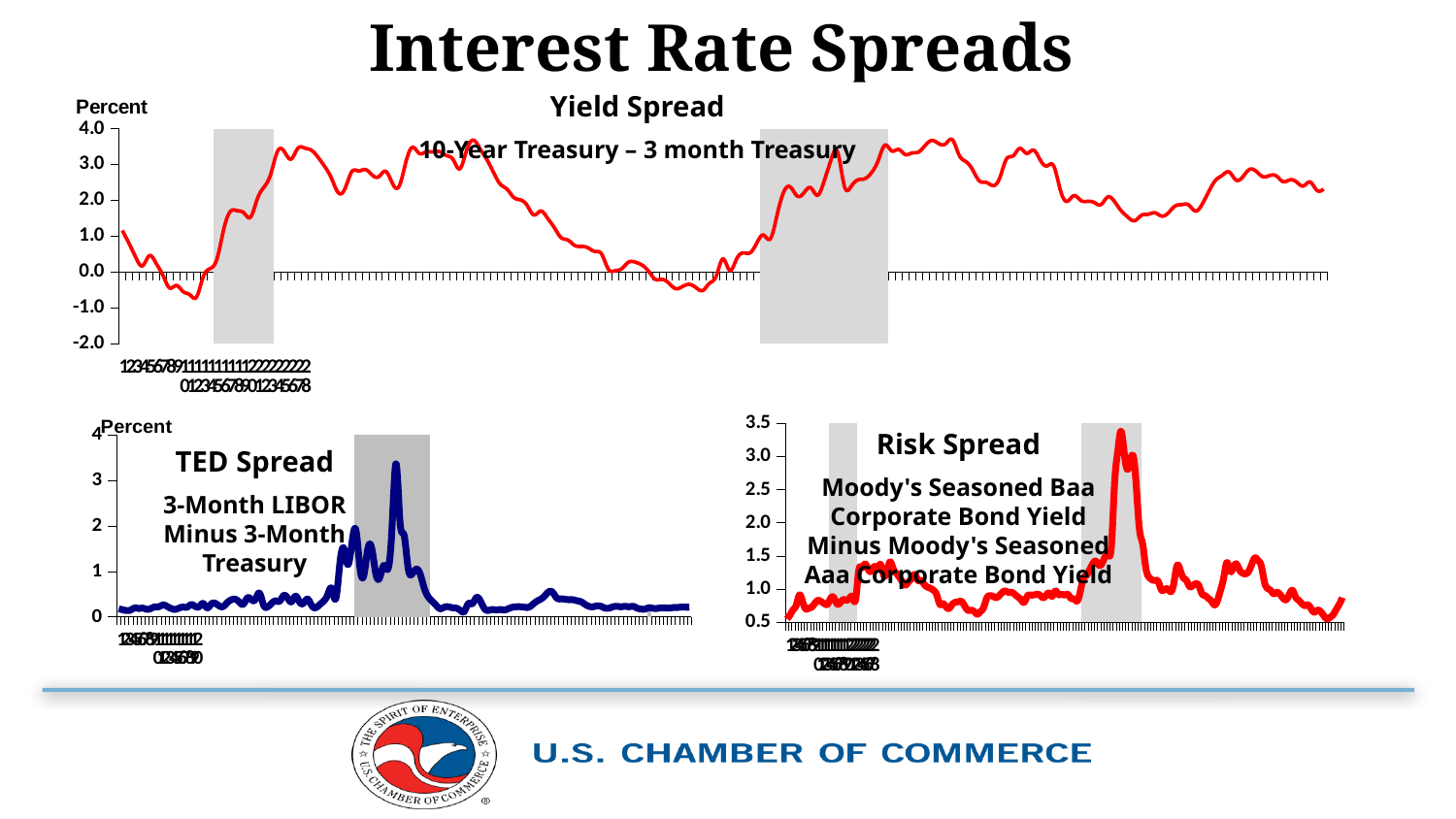
What kind of chart is the Yield Spread chart at the top of the slide? line chart In the TED Spread chart, is the value at the right end of the line greater or less than 1? less In the Risk Spread chart, is the peak value of the line greater or less than 3.0? greater What subtitle appears under the title of the Yield Spread chart? 10-Year Treasury – 3 month Treasury What colour is the line in the TED Spread chart? blue In the Yield Spread chart, is the highest value reached by the line greater or less than 3.0? greater What kind of chart is the TED Spread chart at the bottom left? line chart What kind of chart is the Risk Spread chart at the bottom right? line chart